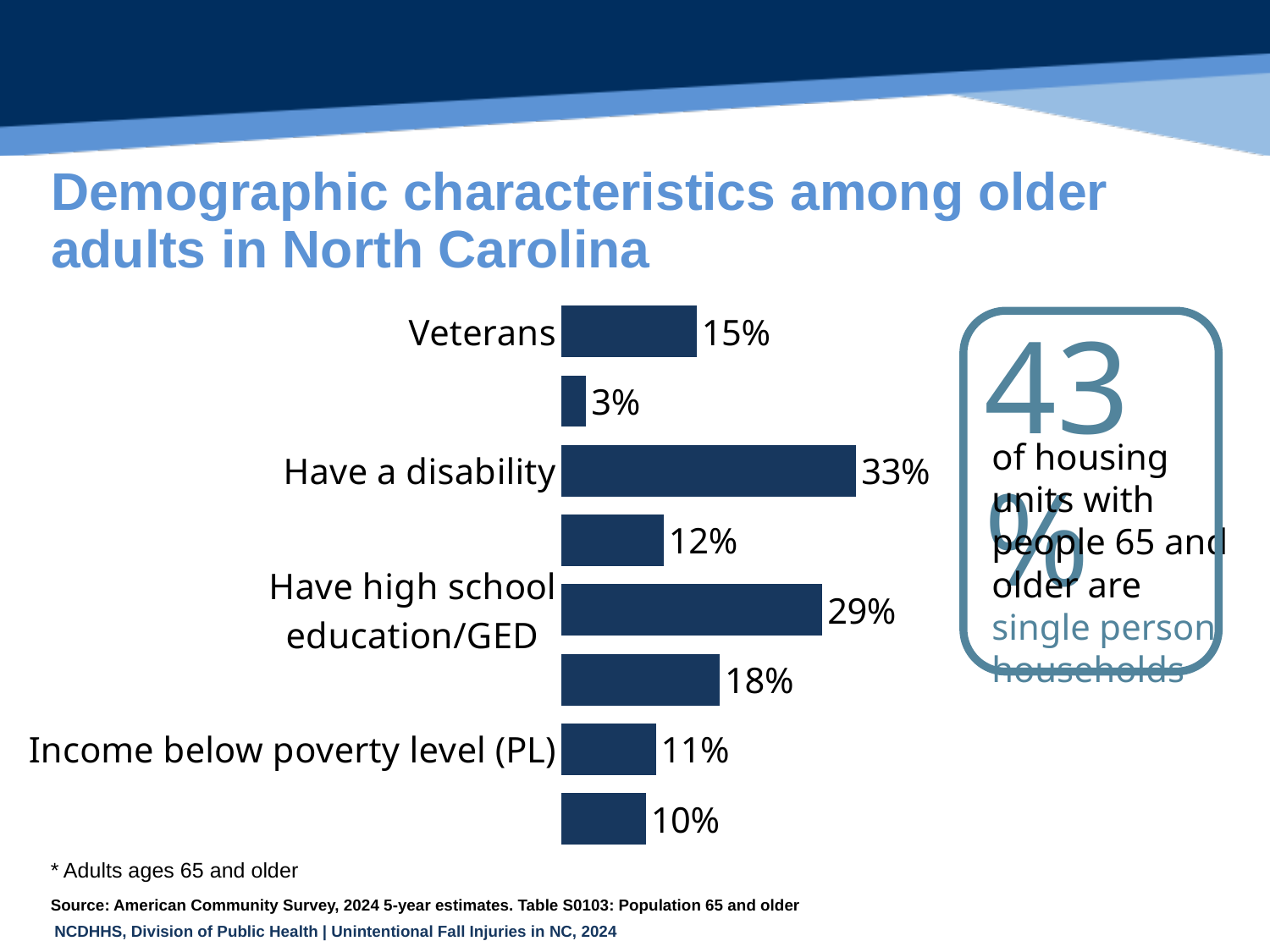
What is the difference between the values for Have a disability and Veterans? 18% How many bars are plotted in the chart? 8 Which labeled category has the lowest value? Income below poverty level (PL) What kind of chart is shown on the slide? bar chart What is the value for Veterans? 15% What is the value for Have high school education/GED? 29% What is the value for Have a disability? 33% What is the smallest value shown on any bar in the chart? 3% What is the difference between the values for Veterans and Income below poverty level (PL)? 4% Which labeled category has the highest value? Have a disability Which is larger, the value for Have high school education/GED or the value for Income below poverty level (PL)? Have high school education/GED What is the value for Income below poverty level (PL)? 11%